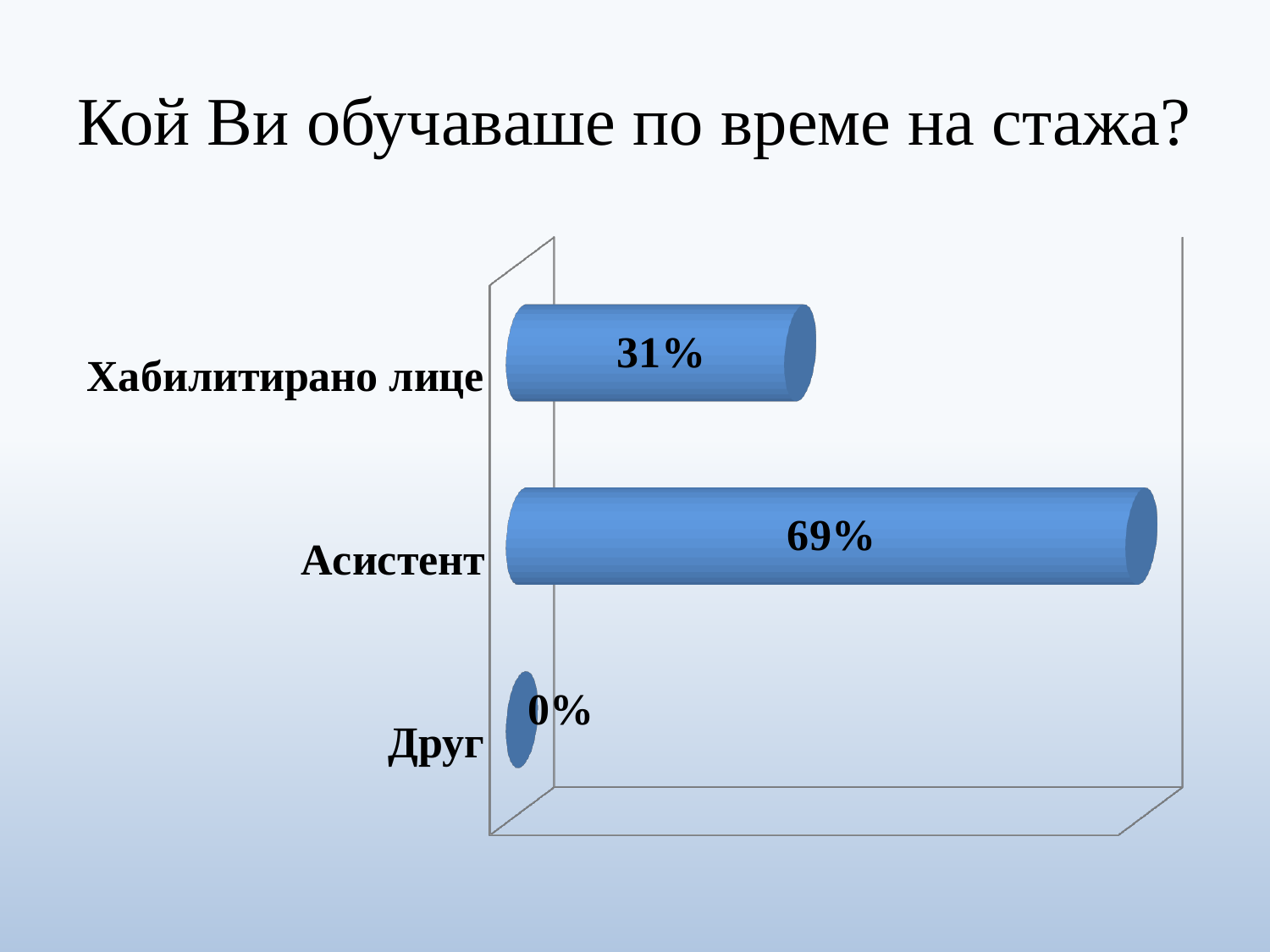
Which category has the lowest value? Друг What colour are the bars in the chart? Blue What is the value for Асистент? 69% What is the total of the values for Хабилитирано лице and Асистент? 100% How many categories are shown in the chart? 3 Which is larger, the value for Хабилитирано лице or the value for Асистент? Асистент What is the difference between the values for Асистент and Хабилитирано лице? 38% What is the value for Друг? 0% Which category has the highest value? Асистент What is the value for Хабилитирано лице? 31% What kind of chart is shown on the slide? Bar chart What is the title of the slide? Кой Ви обучаваше по време на стажа?